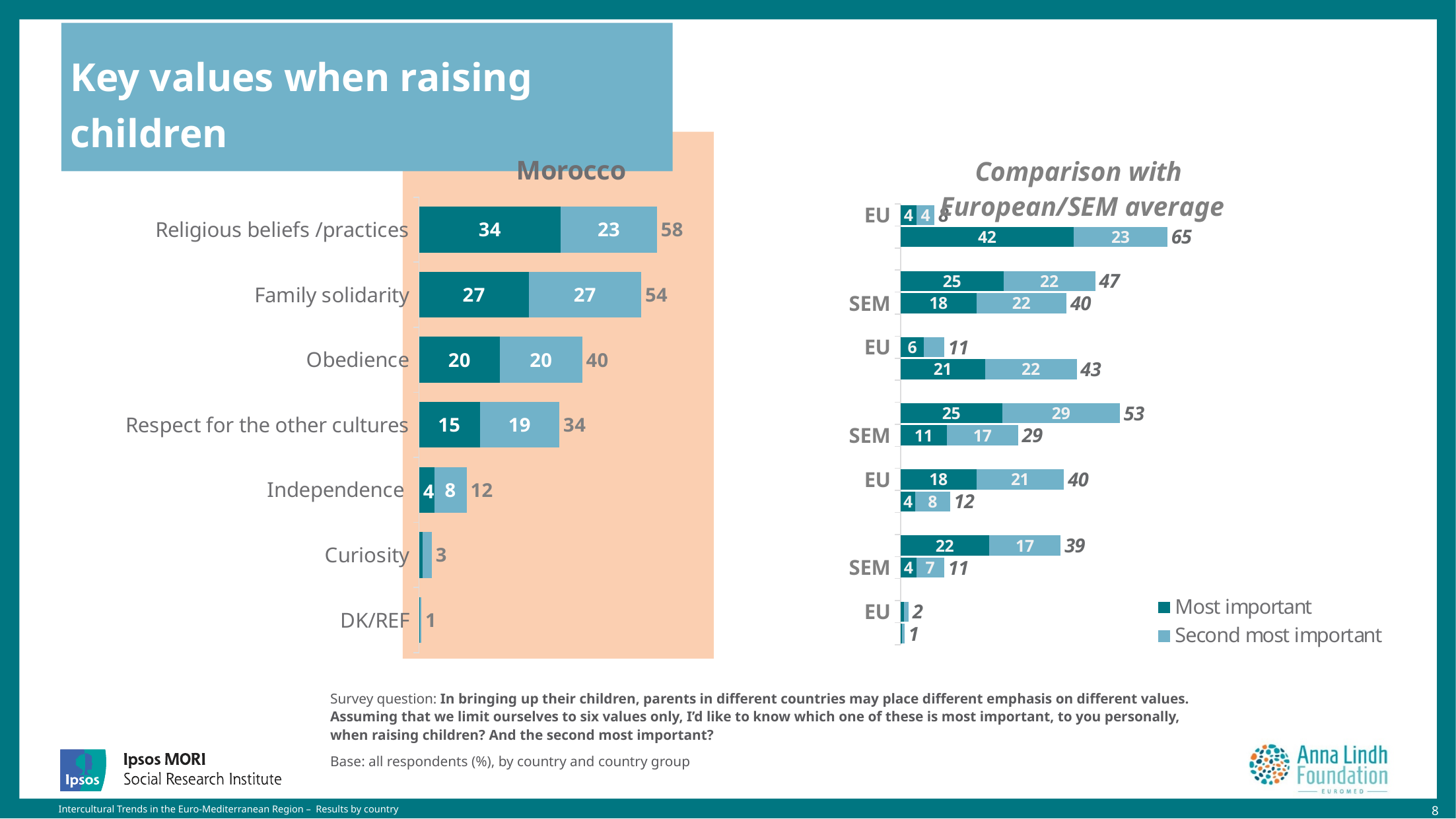
What kind of chart is the Morocco chart? Stacked bar chart In the Morocco chart, what is the total of the stacked bar for Independence? 12 In the Morocco chart, what is the total value for Religious beliefs /practices? 58 In the Morocco chart, which has a larger total: Obedience or Respect for the other cultures? Obedience In the Morocco chart, what is the difference between the totals for Religious beliefs /practices and Family solidarity? 4 In the Morocco chart, what is the 'Second most important' value for Respect for the other cultures? 19 In the Morocco chart, which category has the lowest total? DK/REF How many series does the legend on the slide list? 2 In the Morocco chart, what is the 'Most important' value for Family solidarity? 27 How many categories are shown in the Morocco chart? 7 In the Morocco chart, which category has the highest total? Religious beliefs /practices What is the title of the chart on the right side of the slide? Comparison with European/SEM average